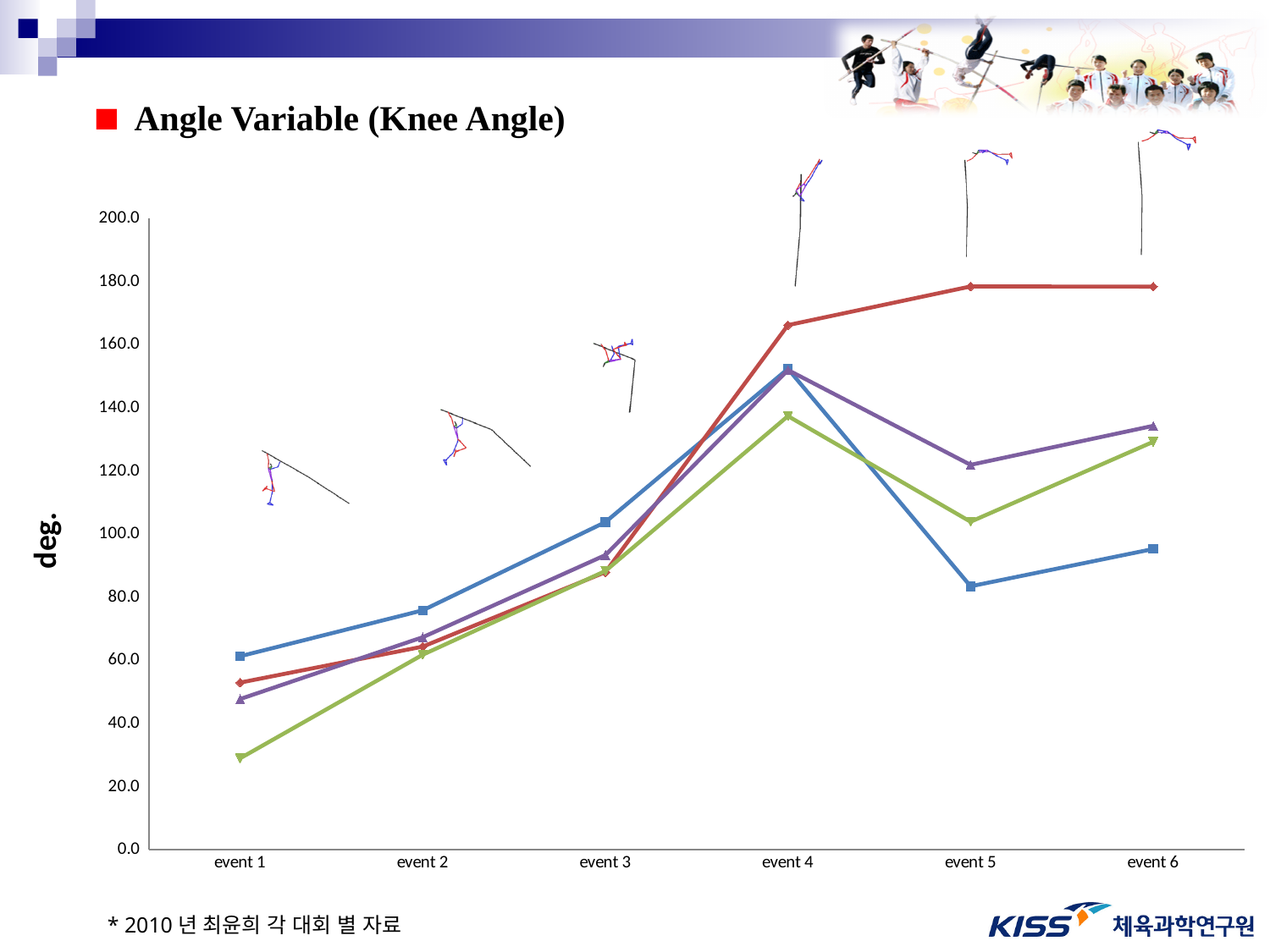
Is the value of the red line at event 5 greater or less than 160? greater Is the value of the blue line at event 4 greater or less than 140? greater What is the label on the y axis? deg. At which event does the green line have its lowest value? event 1 What kind of chart is shown on the slide? line chart Is the value of the blue line at event 5 greater or less than 100? less At which event does the blue line reach its highest value? event 4 At event 6, which line has the larger value, the red line or the blue line? red line How many events are plotted along the x axis? 6 Does the blue line rise or fall from event 1 to event 4? rise What is the title of the chart? Angle Variable (Knee Angle)